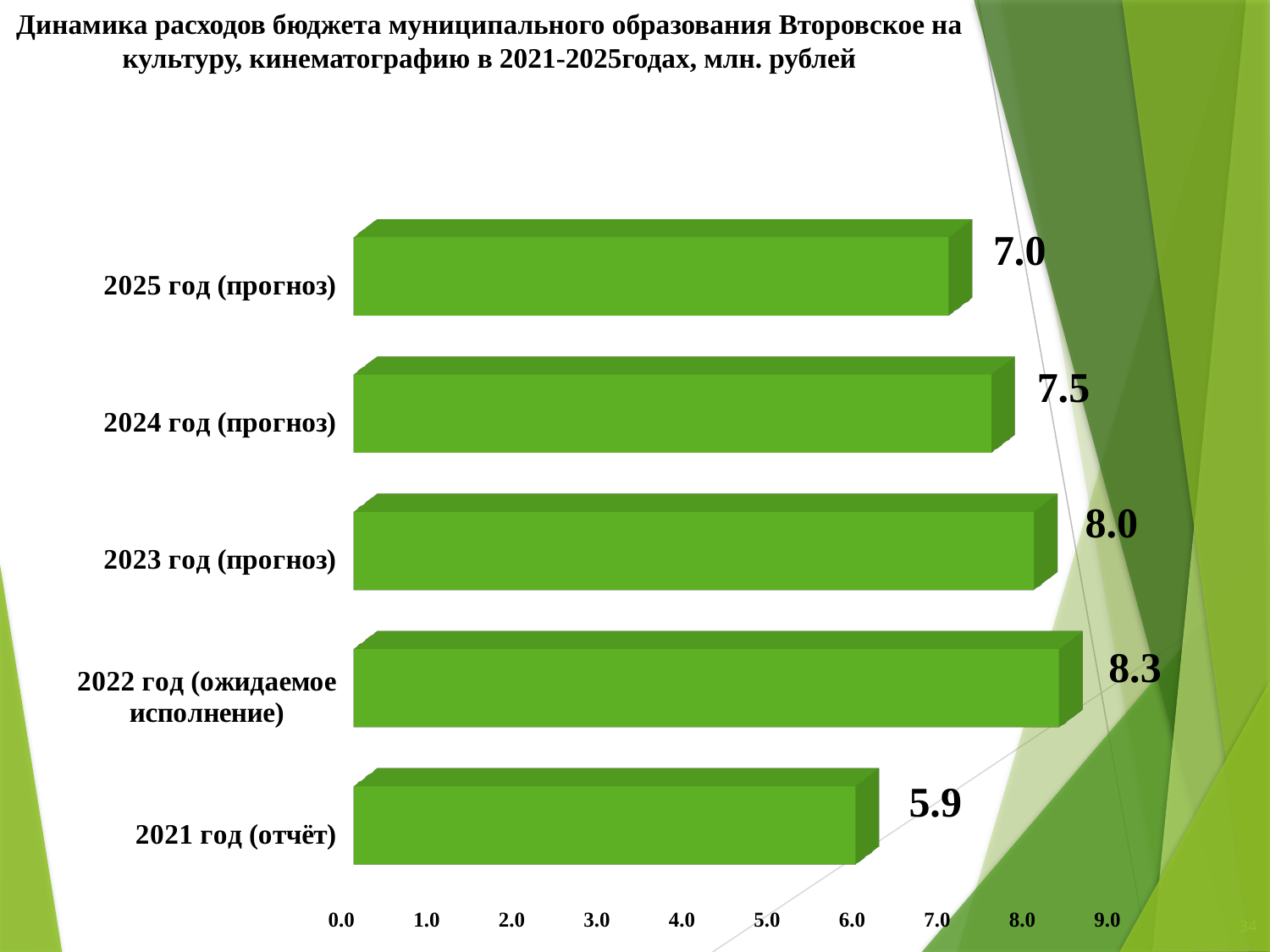
What is the value for 2025 год (прогноз)? 7.0 What is the difference between the values for 2022 год (ожидаемое исполнение) and 2021 год (отчёт)? 2.4 What is the difference between the values for 2024 год (прогноз) and 2025 год (прогноз)? 0.5 What is the value for 2022 год (ожидаемое исполнение)? 8.3 Which is larger, the value for 2023 год (прогноз) or 2024 год (прогноз)? 2023 год (прогноз) What is the value for 2023 год (прогноз)? 8.0 What unit of measurement is stated in the chart title? млн. рублей How many categories are shown in the chart? 5 What kind of chart is shown on the slide? bar chart Which year has the highest value? 2022 год (ожидаемое исполнение) What is the value for 2021 год (отчёт)? 5.9 Which year has the lowest value? 2021 год (отчёт)